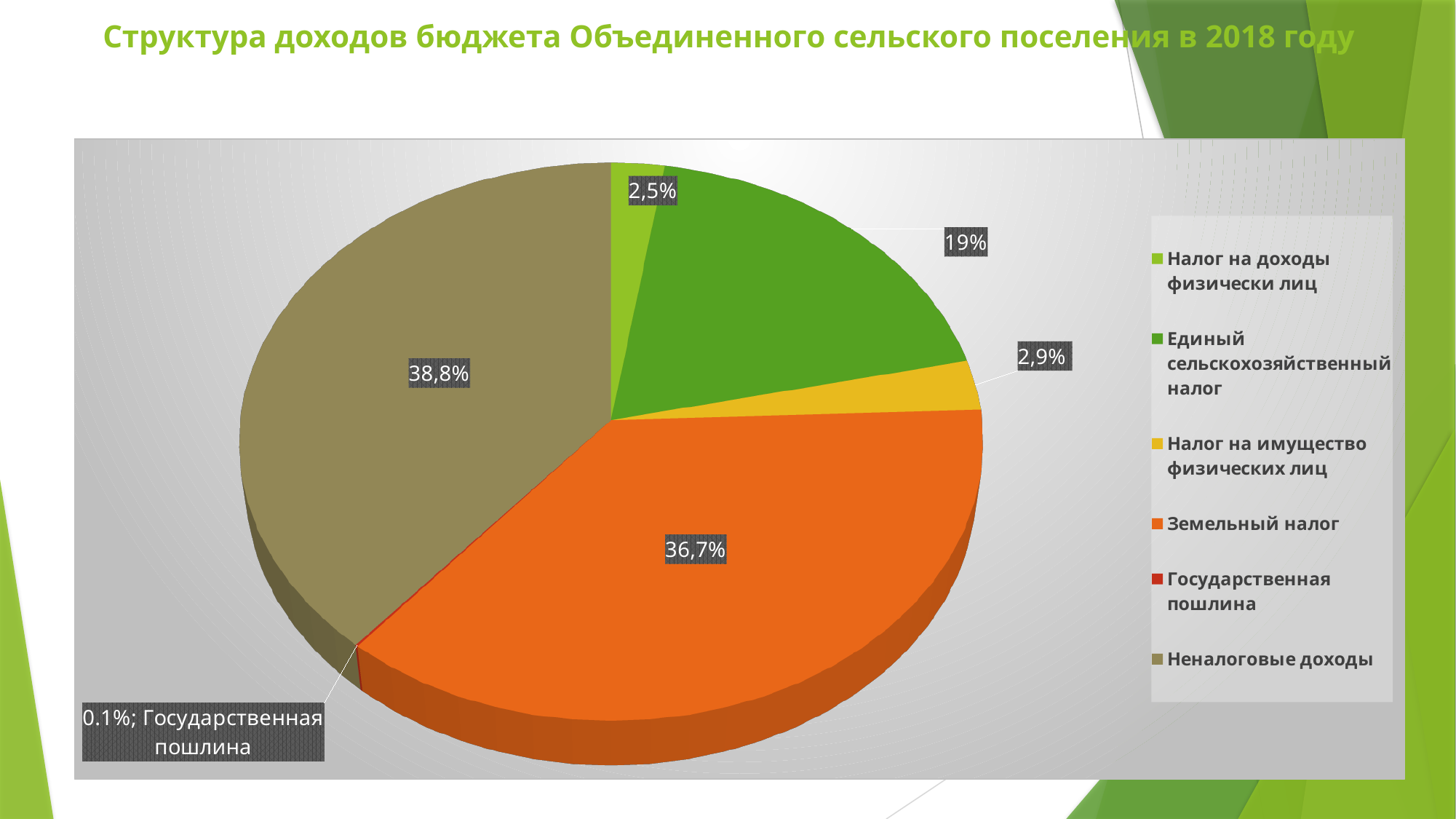
What share of the budget revenue is Государственная пошлина? 0.1% What is the title of the chart? Структура доходов бюджета Объединенного сельского поселения в 2018 году What share of the budget revenue is Неналоговые доходы? 38,8% What is the difference in percentage points between Неналоговые доходы and Земельный налог? 2,1 What share of the budget revenue is Единый сельскохозяйственный налог? 19% Which is larger: the share of Налог на имущество физических лиц or the share of Налог на доходы физически лиц? Налог на имущество физических лиц Which revenue source has the largest share of the pie? Неналоговые доходы How many categories does the legend list? 6 What share of the budget revenue is Налог на имущество физических лиц? 2,9% Which revenue source has the smallest share of the pie? Государственная пошлина What kind of chart is shown on the slide? Pie chart What share of the budget revenue is Земельный налог? 36,7%